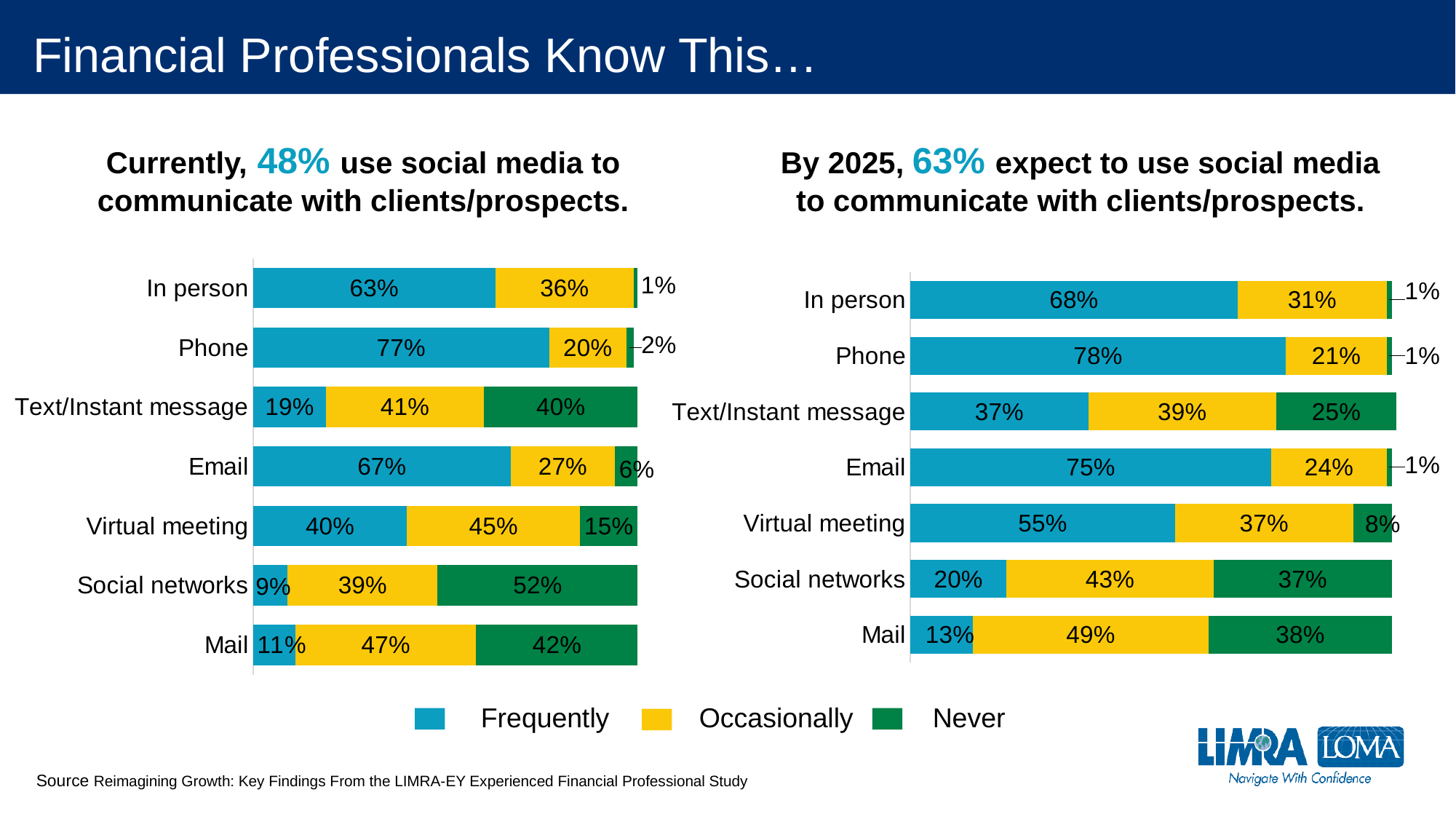
Which colour represents 'Never' in the legend? Green In the left chart (Currently), what percentage of financial professionals use the phone frequently? 77% What is the difference between the 'Frequently' percentage for Text/Instant message in the right chart (By 2025) and in the left chart (Currently)? 18% How many series does the legend list? 3 How many communication methods are listed in the left chart (Currently)? 7 In the left chart (Currently), which is larger: the 'Frequently' percentage for Email or for In person? Email What kind of chart is used on this slide? Stacked bar chart In the right chart (By 2025), what percentage expect to never use social networks? 37% In the left chart (Currently), which communication method has the highest 'Never' percentage? Social networks In the right chart (By 2025), which communication method has the lowest 'Frequently' percentage? Mail In the right chart (By 2025), what percentage expect to use virtual meetings frequently? 55% In the left chart (Currently), what percentage use mail occasionally? 47%